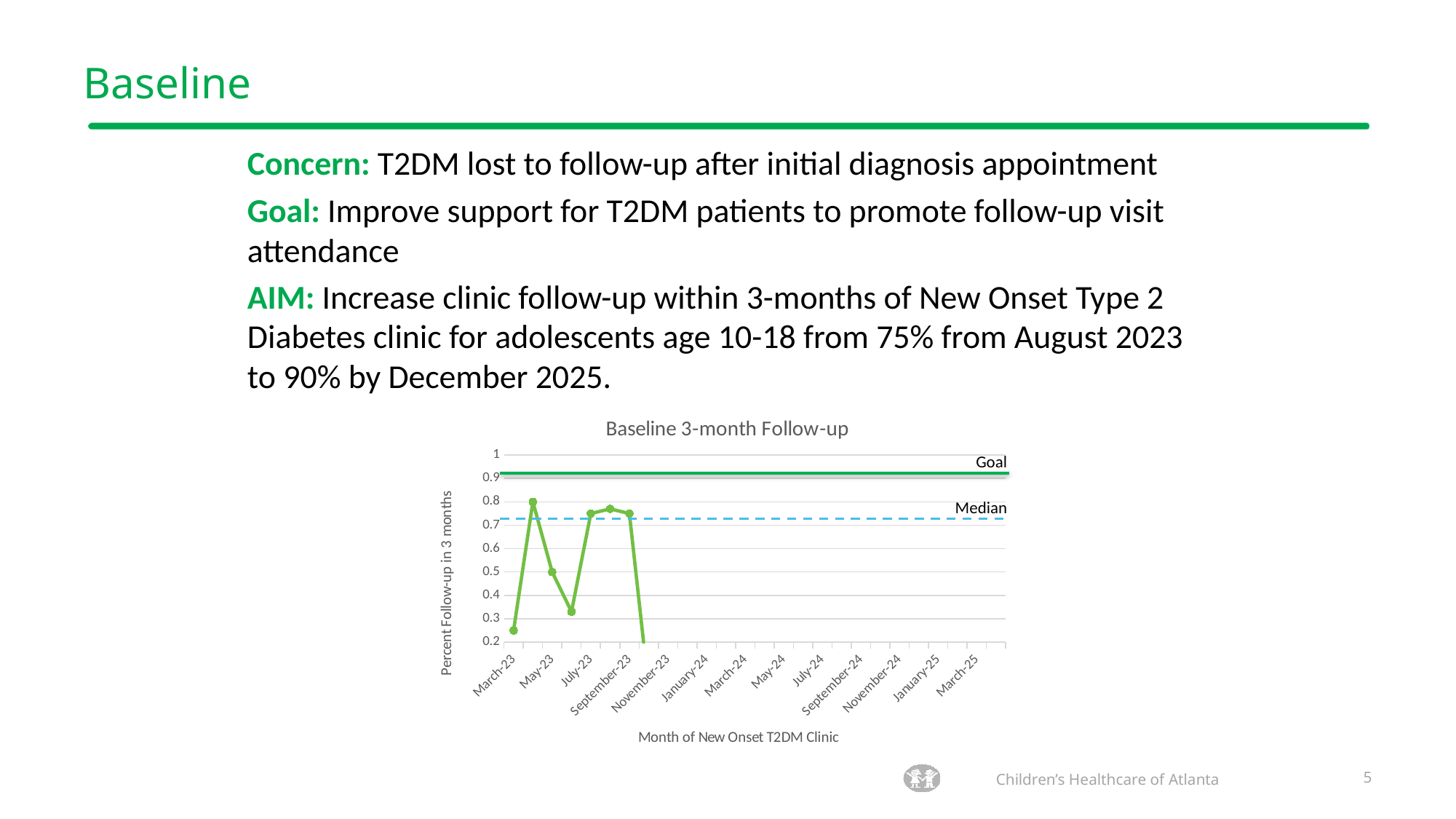
What is the title of the chart? Baseline 3-month Follow-up Is the value for March-23 greater or less than 0.4? less Is the value for September-23 greater or less than 0.5? greater What are the two horizontal reference lines on the chart labelled? Goal and Median Is the value for May-23 greater or less than 0.6? less What kind of chart is shown on the slide? line chart Which is higher, the value for March-23 or the value for May-23? May-23 Which reference line is higher on the chart, Goal or Median? Goal Does the plotted line rise or fall between March-23 and the next month? rise